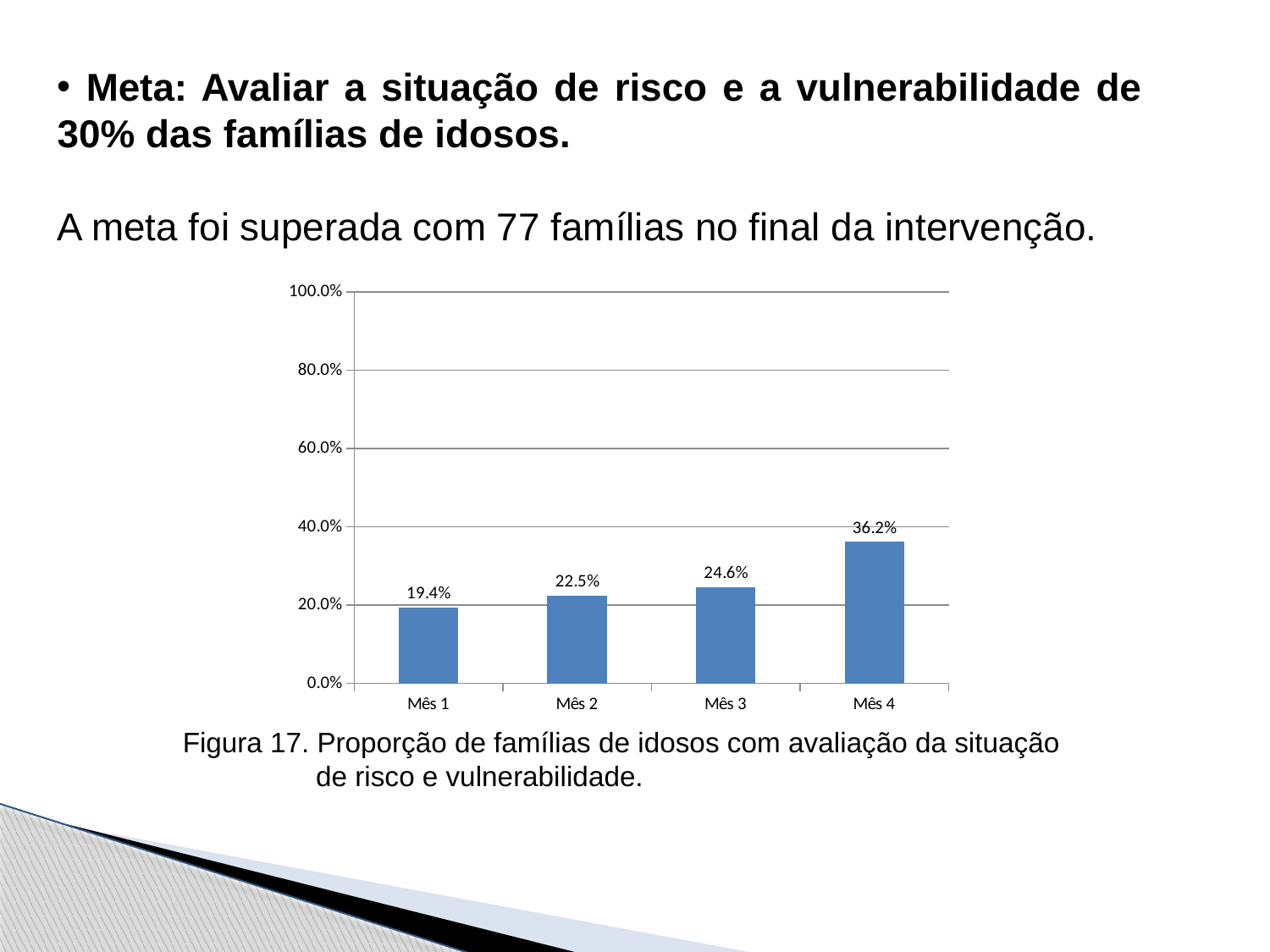
How many months are shown on the x axis? 4 What is the difference between the values for Mês 4 and Mês 1? 16.8% Which month has the highest value? Mês 4 What kind of chart is shown on the slide? bar chart Is the value for Mês 4 greater or less than 40.0%? less What is the value for Mês 4? 36.2% What is the value for Mês 3? 24.6% What is the value for Mês 1? 19.4% What is the difference between the values for Mês 3 and Mês 2? 2.1% Do the values rise or fall from Mês 1 to Mês 4? rise Which month has the lowest value? Mês 1 Which is larger, the value for Mês 2 or the value for Mês 3? Mês 3